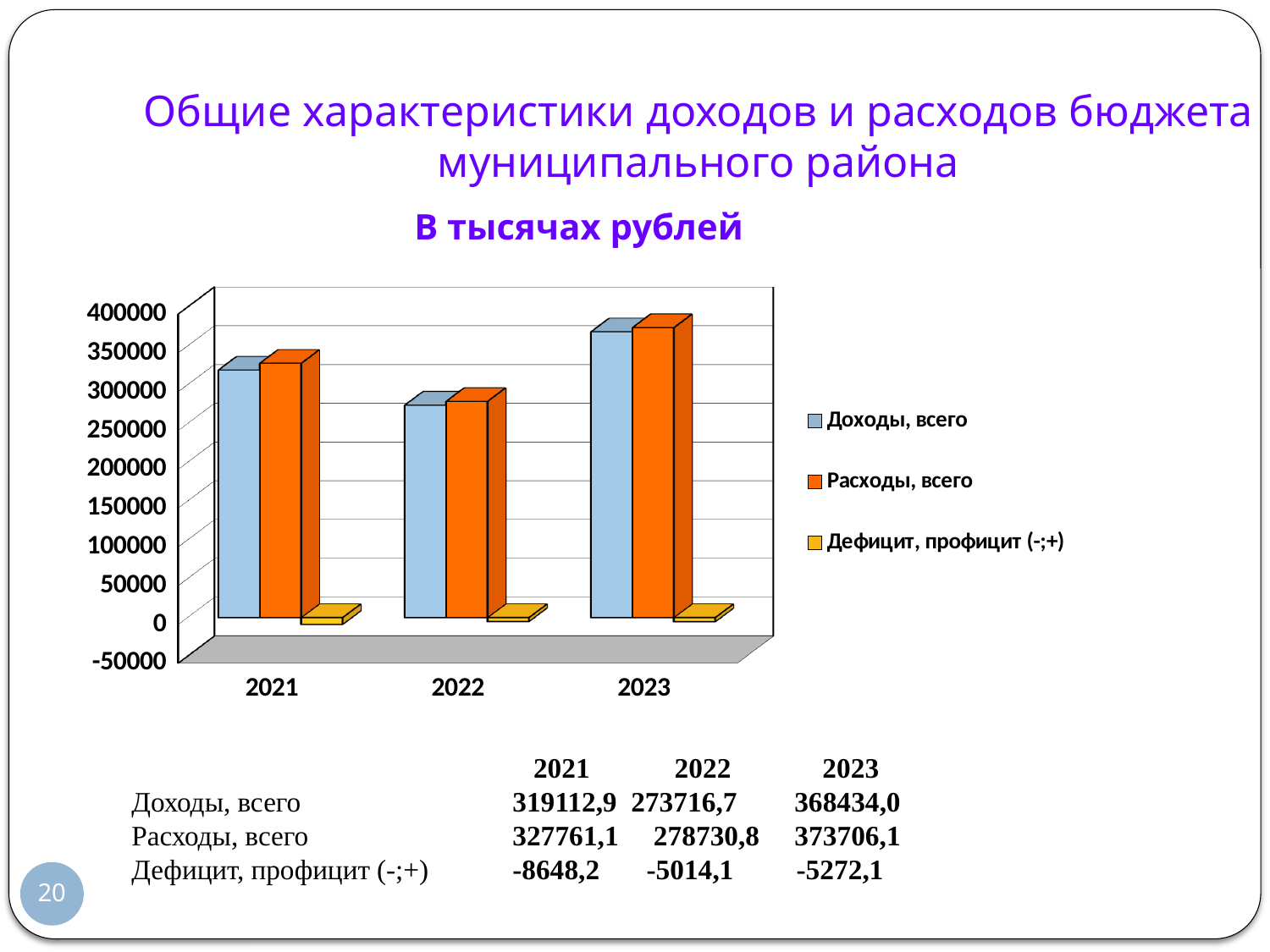
What is the value of Расходы, всего for 2023? 373706,1 How many series does the legend list? 3 In which year is Расходы, всего the lowest? 2022 How many years are shown on the x axis of the chart? 3 What is the value of Доходы, всего for 2021? 319112,9 By how much did Доходы, всего increase from 2022 to 2023? 94717,3 What kind of chart is shown on the slide? bar chart In 2022, which is larger: Доходы, всего or Расходы, всего? Расходы, всего What is the value of Дефицит, профицит (-;+) for 2022? -5014,1 Is the value of Доходы, всего for 2023 greater or less than 350000? greater In which year is Доходы, всего the highest? 2023 What is the difference between Расходы, всего and Доходы, всего in 2021? 8648,2